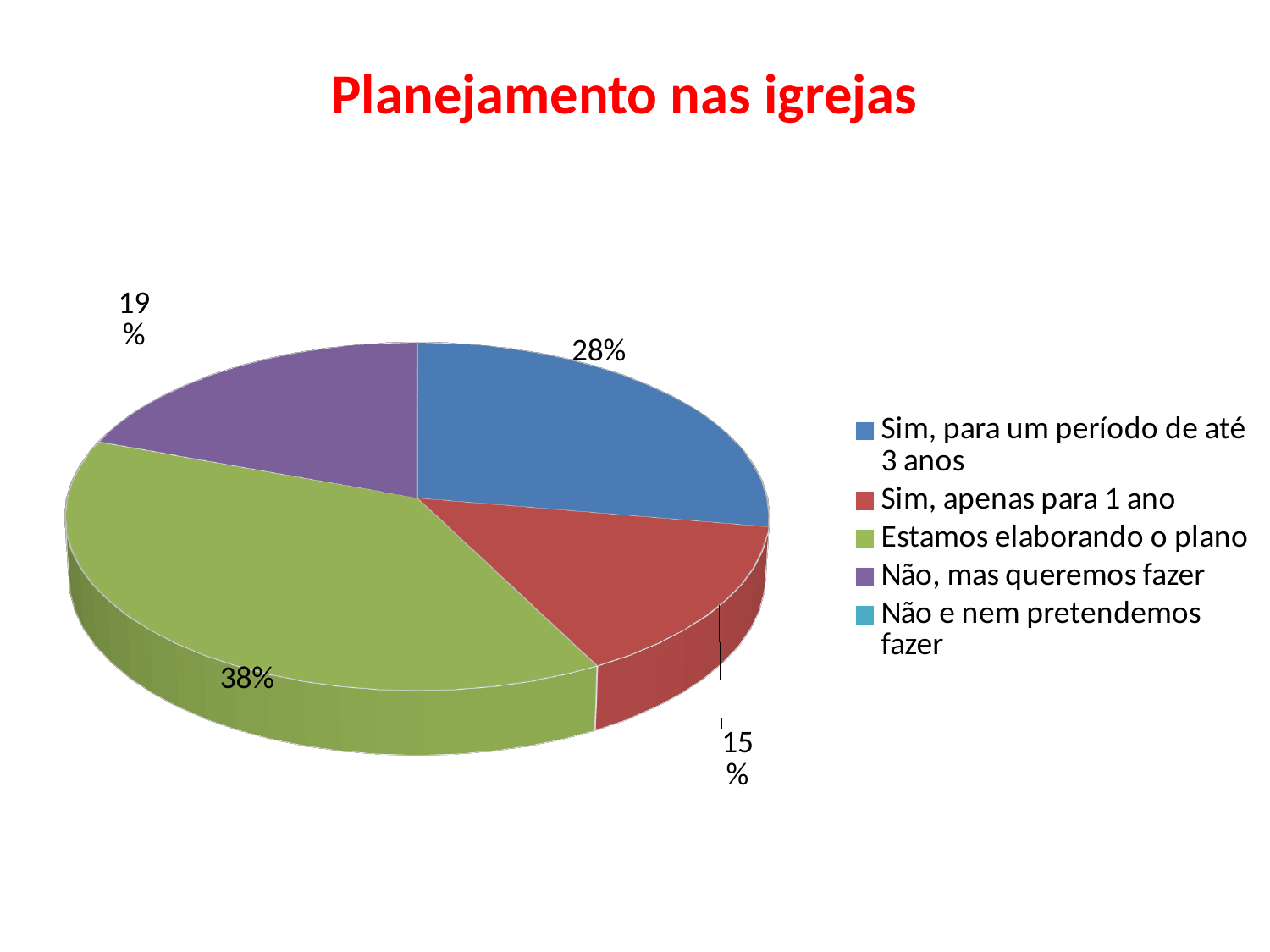
What colour represents "Não, mas queremos fazer" in the pie chart? Purple How many categories are listed in the legend? 5 What percentage is shown for "Sim, apenas para 1 ano"? 15% What type of chart is shown on the slide? Pie chart What is the difference in percentage points between "Estamos elaborando o plano" and "Sim, para um período de até 3 anos"? 10 Which category has the largest slice of the pie? Estamos elaborando o plano What percentage is shown for "Sim, para um período de até 3 anos"? 28% What is the title of the chart? Planejamento nas igrejas What percentage is shown for "Não, mas queremos fazer"? 19% Among the slices with printed percentages, which category has the smallest share? Sim, apenas para 1 ano What percentage of the pie is labelled for "Estamos elaborando o plano"? 38% Which is larger: the share for "Não, mas queremos fazer" or the share for "Sim, apenas para 1 ano"? Não, mas queremos fazer